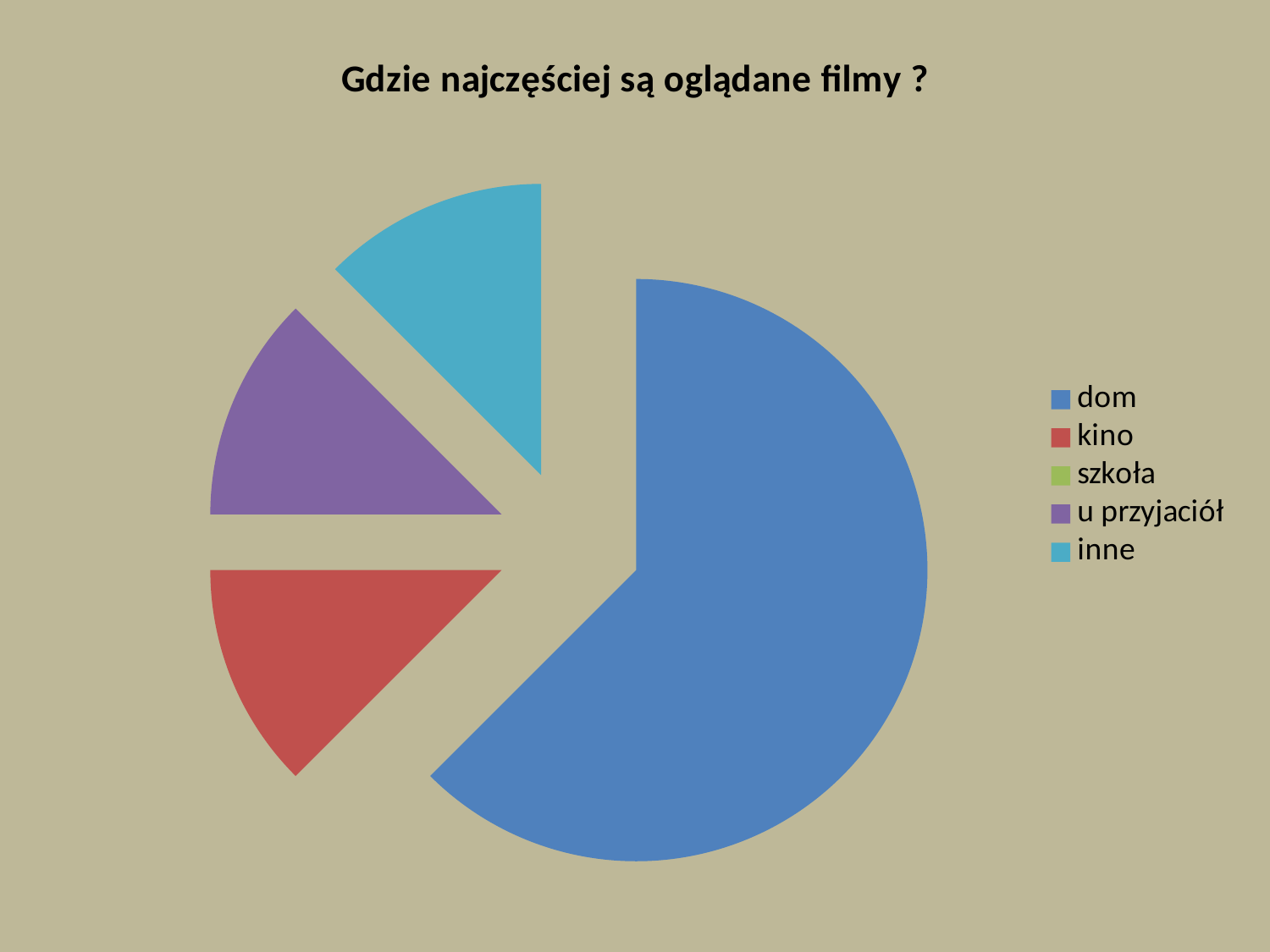
Which category has the largest slice of the pie? dom How many categories does the legend list? 5 Which is larger, the slice for u przyjaciół or the slice for dom? dom What colour is the slice for dom? blue Does the slice for dom take up more or less than half of the pie? more Which is larger, the slice for dom or the slice for kino? dom Which is larger, the slice for dom or the slice for inne? dom Which legend category has no visible slice in the pie? szkoła What is the title of the chart? Gdzie najczęściej są oglądane filmy ? What kind of chart is shown on the slide? pie chart